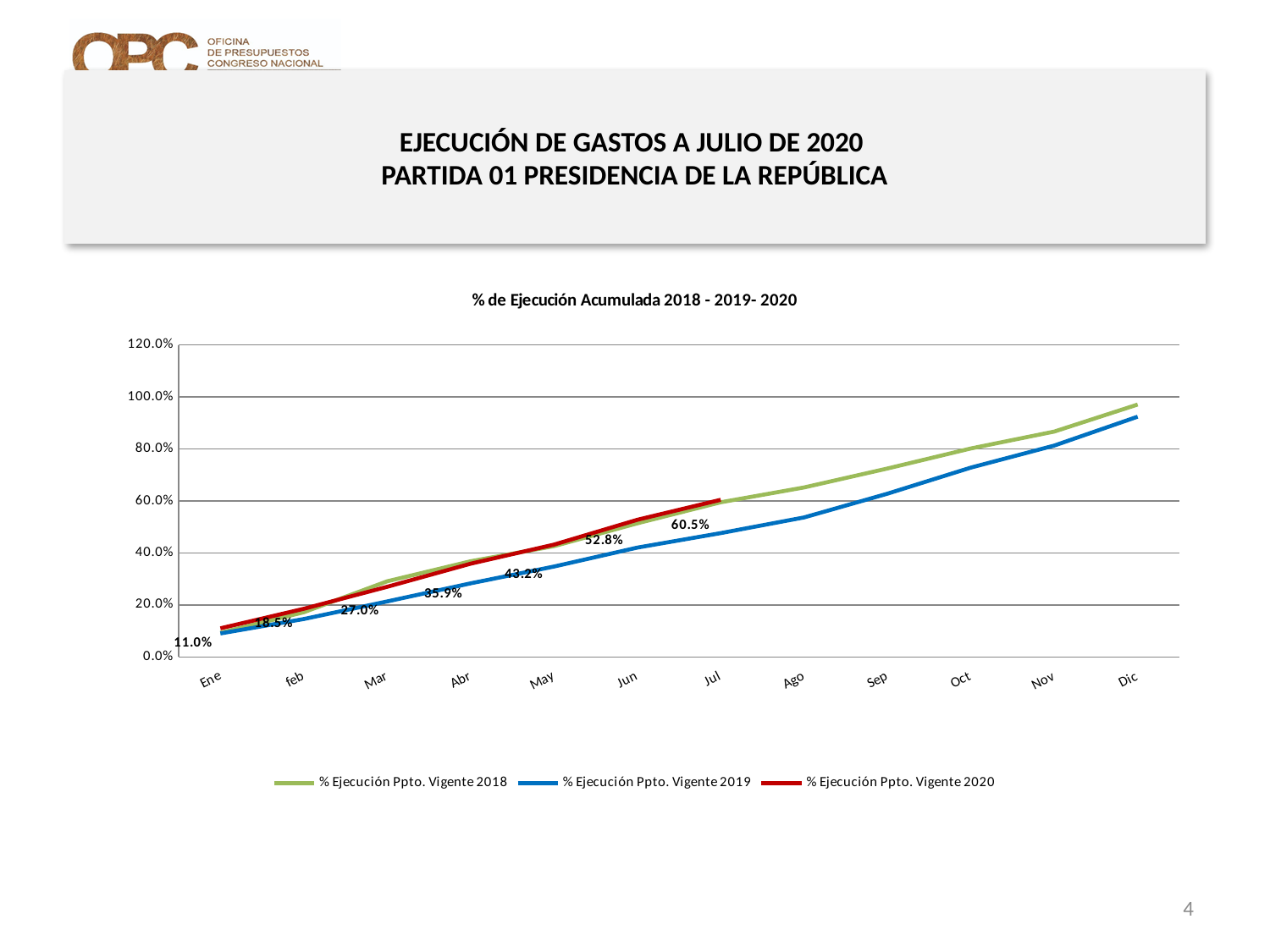
What is the value of % Ejecución Ppto. Vigente 2020 in Abr? 35.9% How many series does the legend list? 3 Is the value for % Ejecución Ppto. Vigente 2019 in Dic greater or less than 80.0%? greater What is the value of % Ejecución Ppto. Vigente 2020 in Jul? 60.5% What kind of chart is shown on the slide? line chart In Oct, which series is larger: % Ejecución Ppto. Vigente 2018 or % Ejecución Ppto. Vigente 2019? % Ejecución Ppto. Vigente 2018 Which month has the highest value for % Ejecución Ppto. Vigente 2020? Jul Do the values of % Ejecución Ppto. Vigente 2019 rise or fall from Ene to Dic? rise How many months are shown on the x axis? 12 What is the value of % Ejecución Ppto. Vigente 2020 in Ene? 11.0% What is the title of the chart? % de Ejecución Acumulada 2018 - 2019- 2020 What is the difference between the % Ejecución Ppto. Vigente 2020 values for Jul and Jun? 7.7%